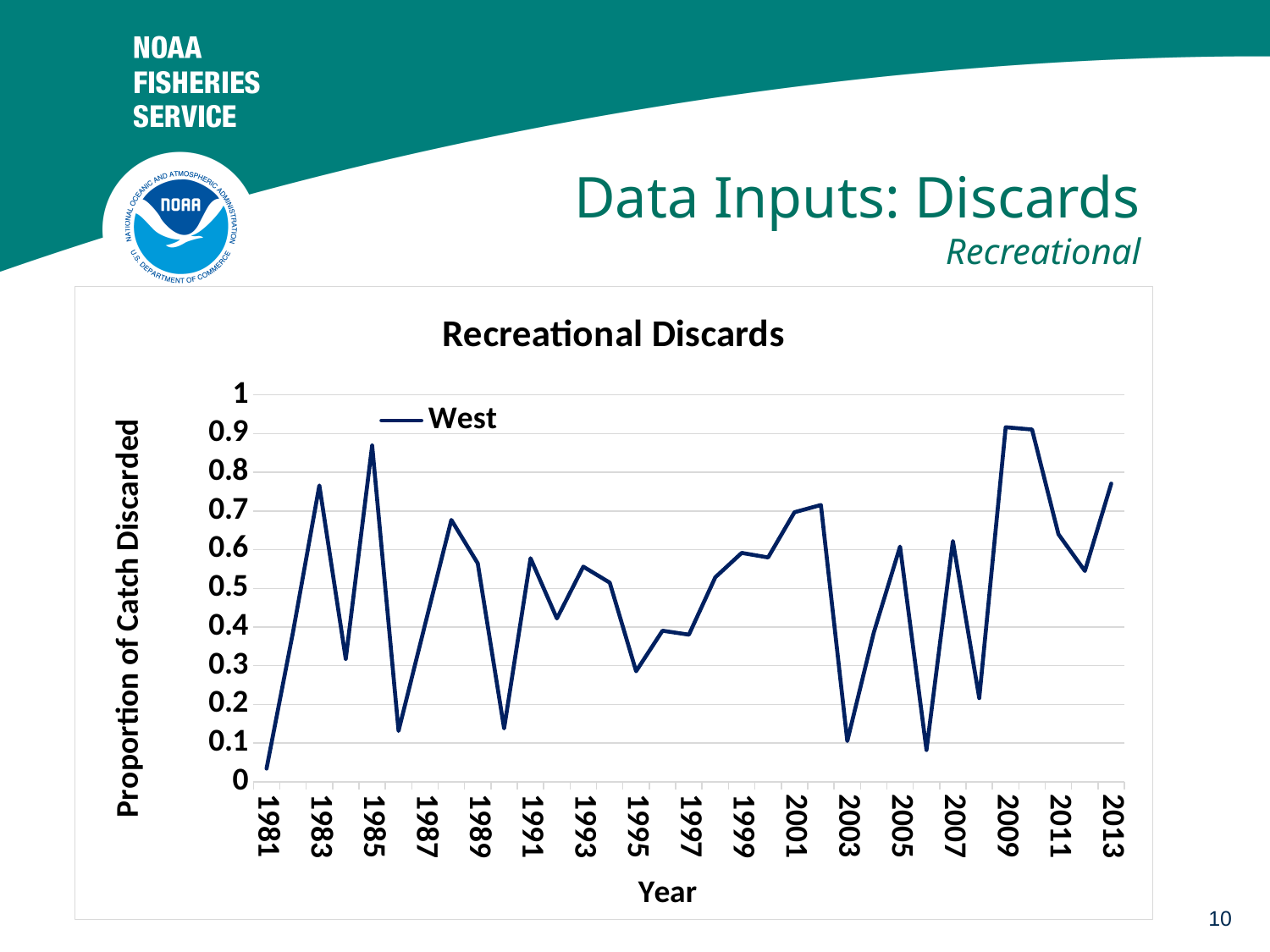
Which year has the larger proportion of catch discarded, 1985 or 1986? 1985 Which year has the larger proportion of catch discarded, 2009 or 2003? 2009 How many series does the legend list? 1 Is the value for 1986 greater or less than 0.2? less Is the value for 1995 greater or less than 0.4? less What is the title of the chart? Recreational Discards What kind of chart is shown on the slide? line chart Is the value for 2013 greater or less than 0.7? greater What is the name of the series shown in the legend? West Which year has the lowest proportion of catch discarded? 1981